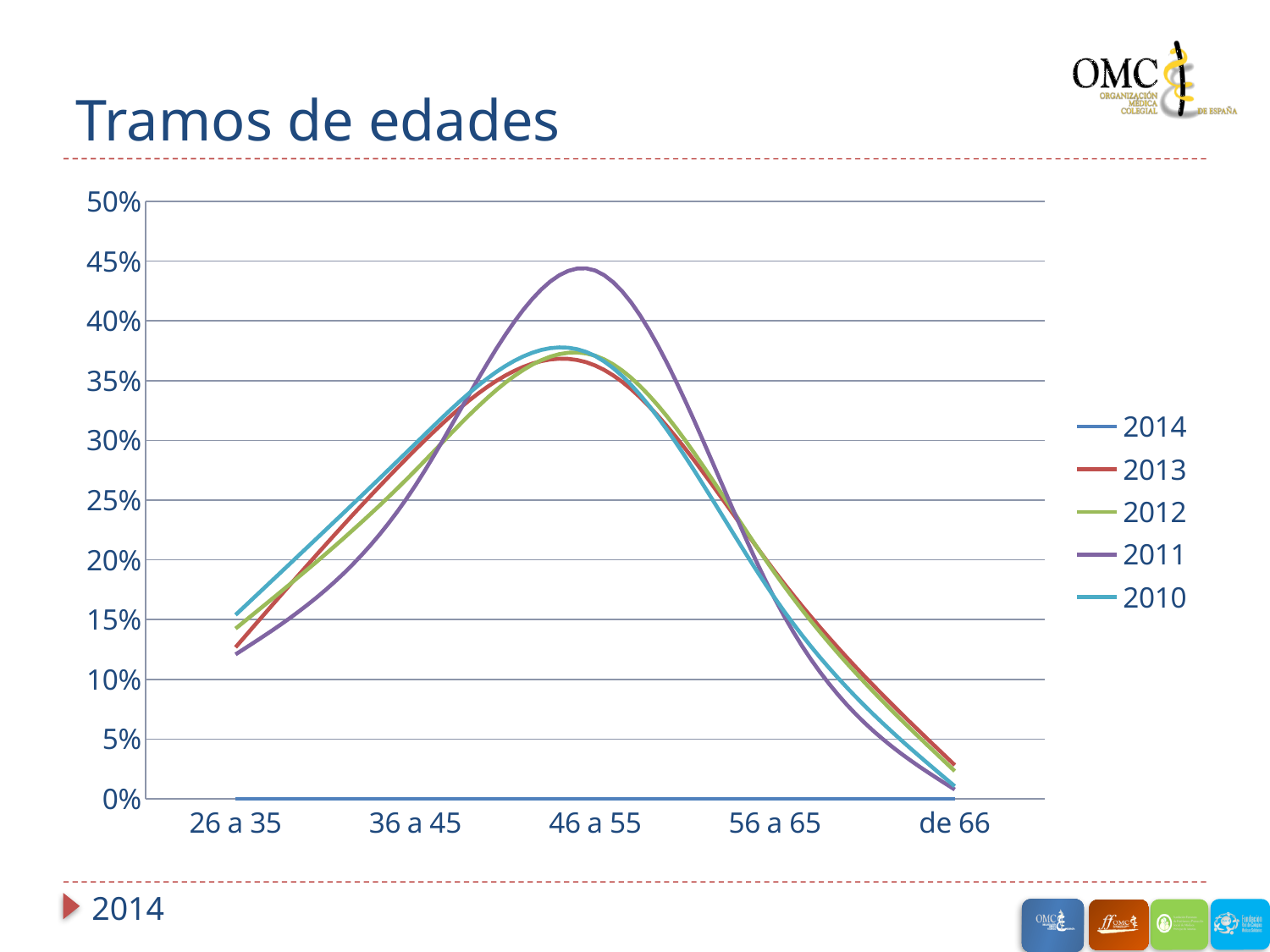
Do the values for the 2012 series rise or fall from 46 a 55 to de 66? fall Is the value for 2011 at de 66 greater or less than 5%? less Is the value for 2013 at 26 a 35 greater or less than 15%? less How many series does the legend list? 5 Is the value for 2011 at 46 a 55 greater or less than 40%? greater What is the title of the chart? Tramos de edades What kind of chart is shown on the slide? line chart How many age-group categories are shown on the x axis? 5 Which age group has the lowest value for the 2013 series? de 66 At 46 a 55, which series has the larger value, 2011 or 2013? 2011 Which age group has the highest value for the 2011 series? 46 a 55